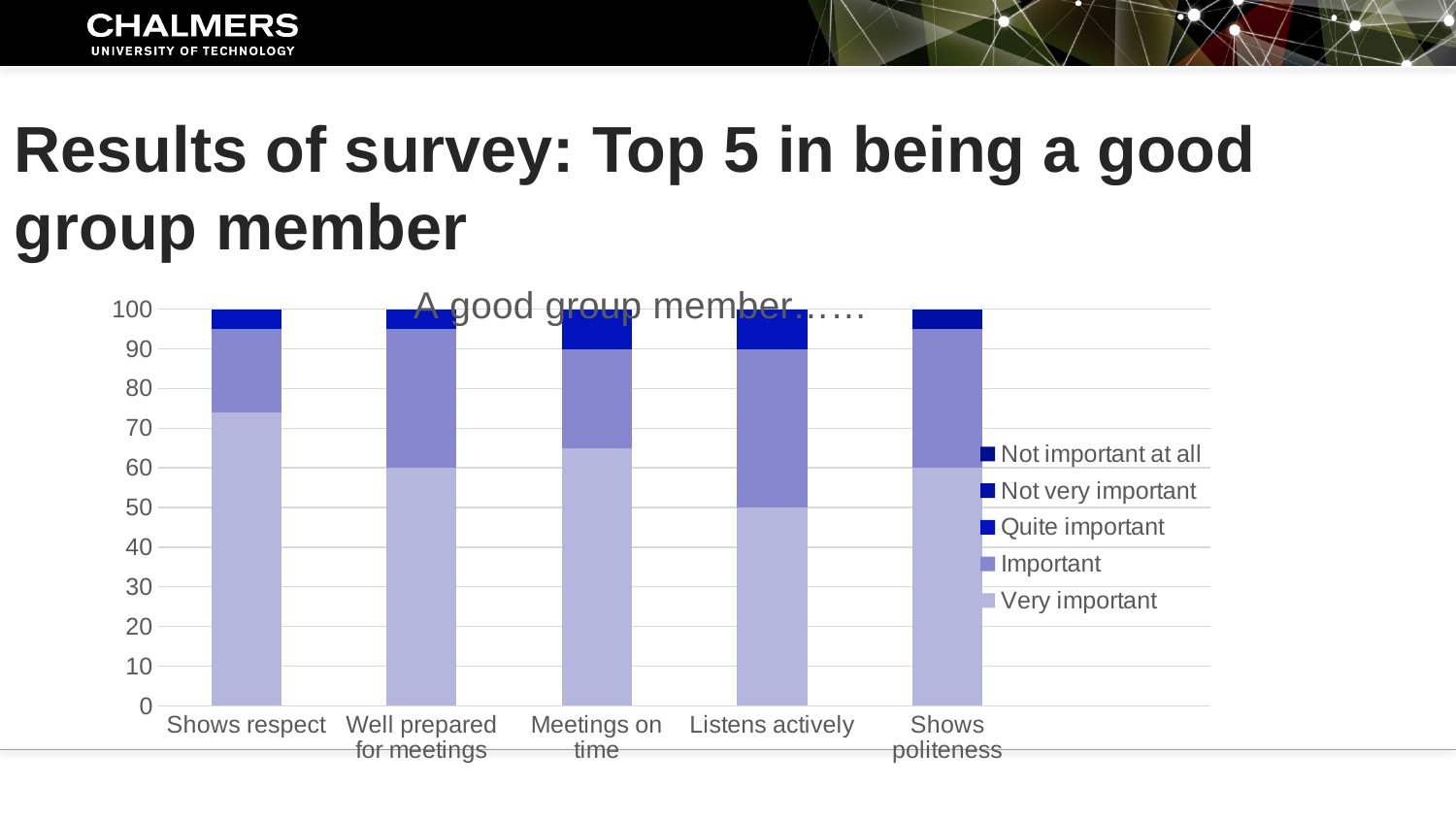
Is the 'Very important' value for Meetings on time greater or less than 60? greater Which legend entry is listed first (at the top) in the chart's legend? Not important at all Which category has the highest value for the 'Very important' series? Shows respect Which has the larger 'Very important' value: Shows respect or Listens actively? Shows respect How many categories are shown on the x axis of the chart? 5 Is the 'Very important' value for Listens actively greater or less than 60? less Which has the larger 'Important' segment: Listens actively or Shows respect? Listens actively What kind of chart is shown on the slide? Stacked bar chart What is the title of the chart? A good group member…… Is the 'Very important' value for Shows respect greater or less than 70? greater How many series does the chart's legend list? 5 Which category has the lowest value for the 'Very important' series? Listens actively